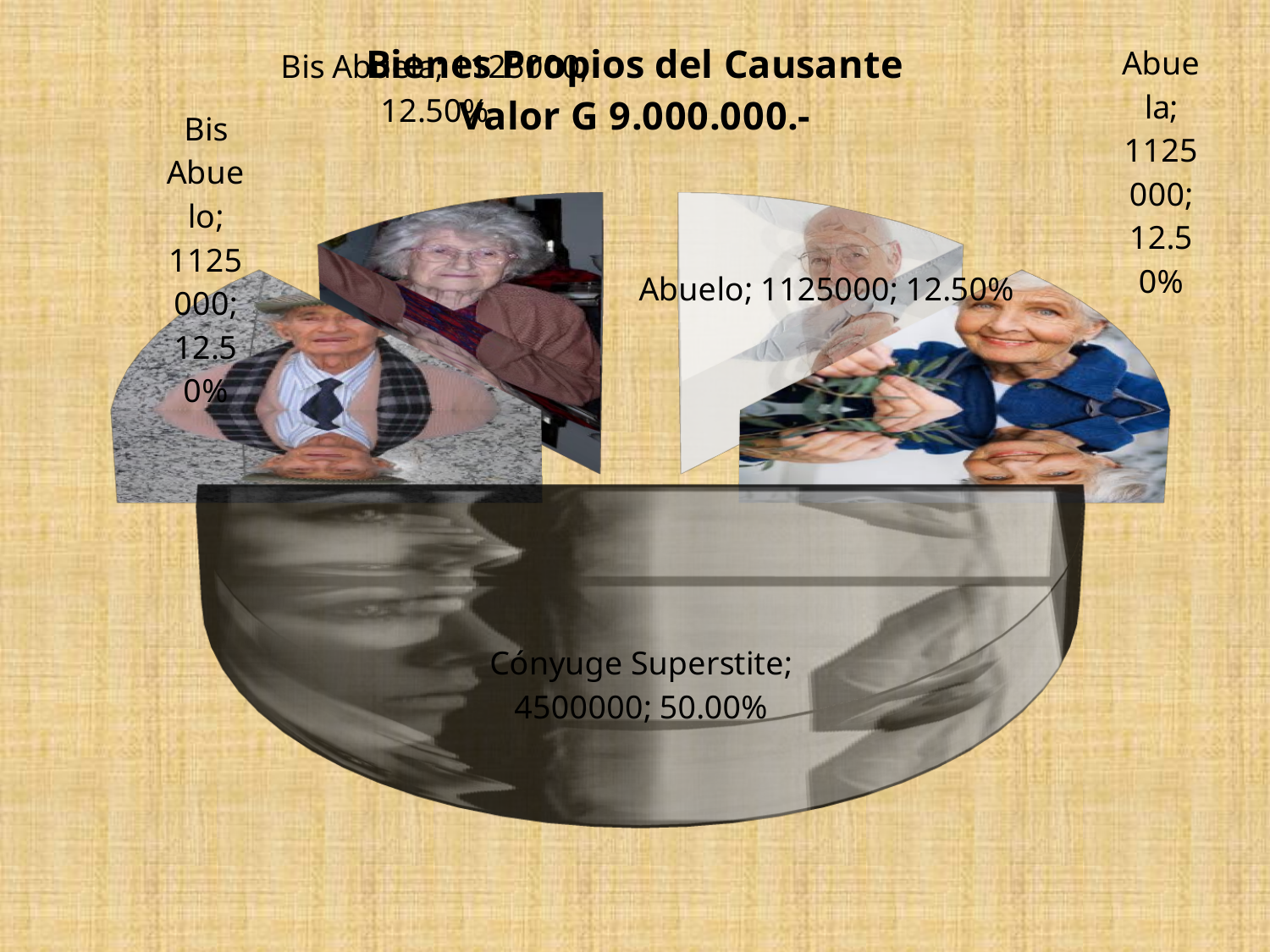
Which category has the largest slice of the pie? Cónyuge Superstite What kind of chart is shown on the slide? pie chart What value is shown for Cónyuge Superstite? 4500000 Which is larger, the value for Cónyuge Superstite or the value for Abuela? Cónyuge Superstite What percentage share does Cónyuge Superstite have? 50.00% What value is shown for Abuelo? 1125000 Is the value for Cónyuge Superstite greater or less than 4000000? greater What value is shown for Bis Abuelo? 1125000 What percentage share does Abuela have? 12.50% What is the difference between the value for Cónyuge Superstite and the value for Abuelo? 3375000 What is the title of the chart? Bienes Propios del Causante Valor G 9.000.000.- How many slices does the pie chart have? 5